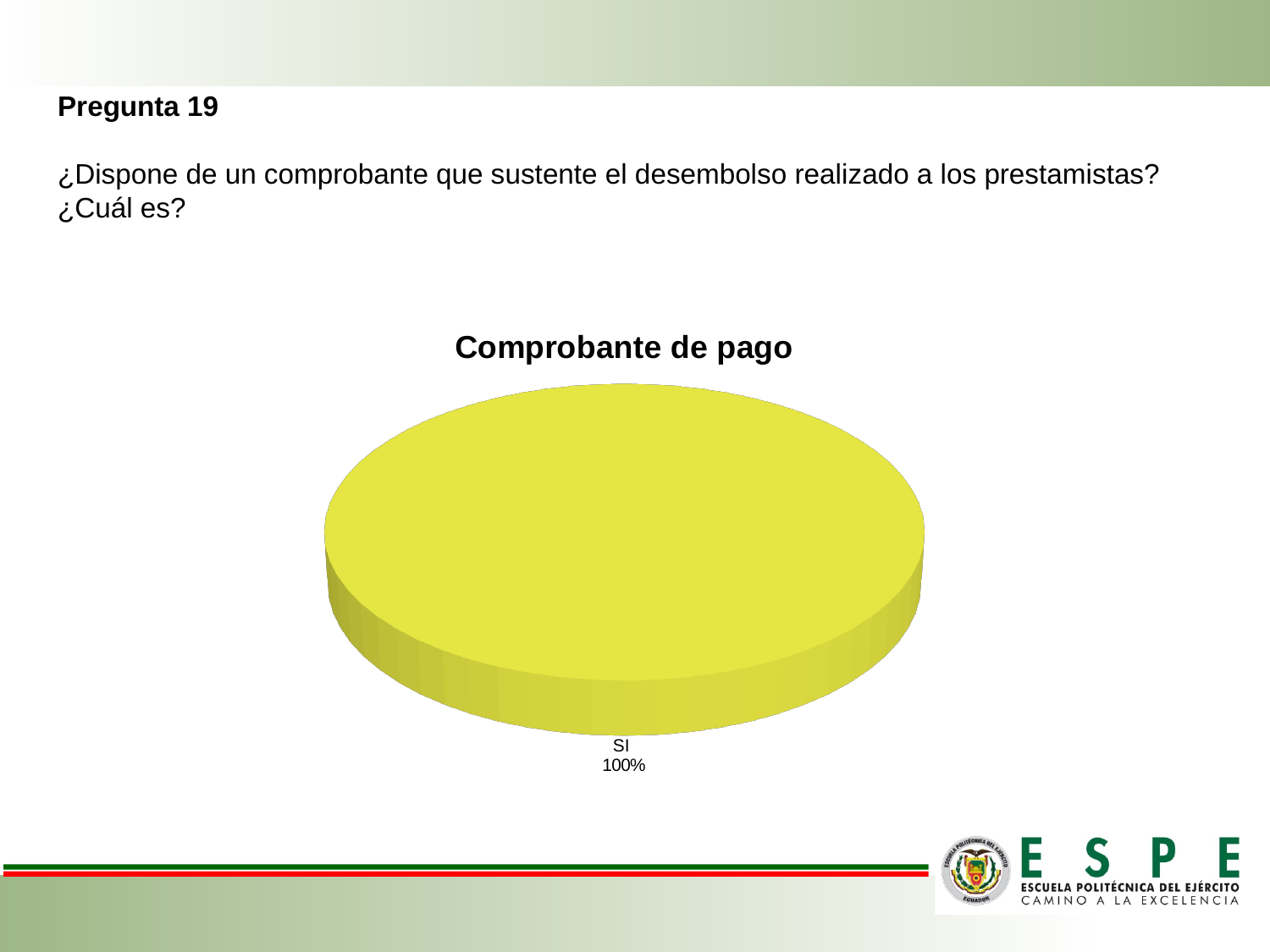
Which category is the largest slice of the pie? SI What kind of chart is shown on the slide? pie chart What is the title of the chart? Comprobante de pago What colour is the SI slice of the pie? yellow What share of the pie does the SI slice represent? 100% How many slices does the pie chart have? 1 What is the value shown for the SI category? 100%